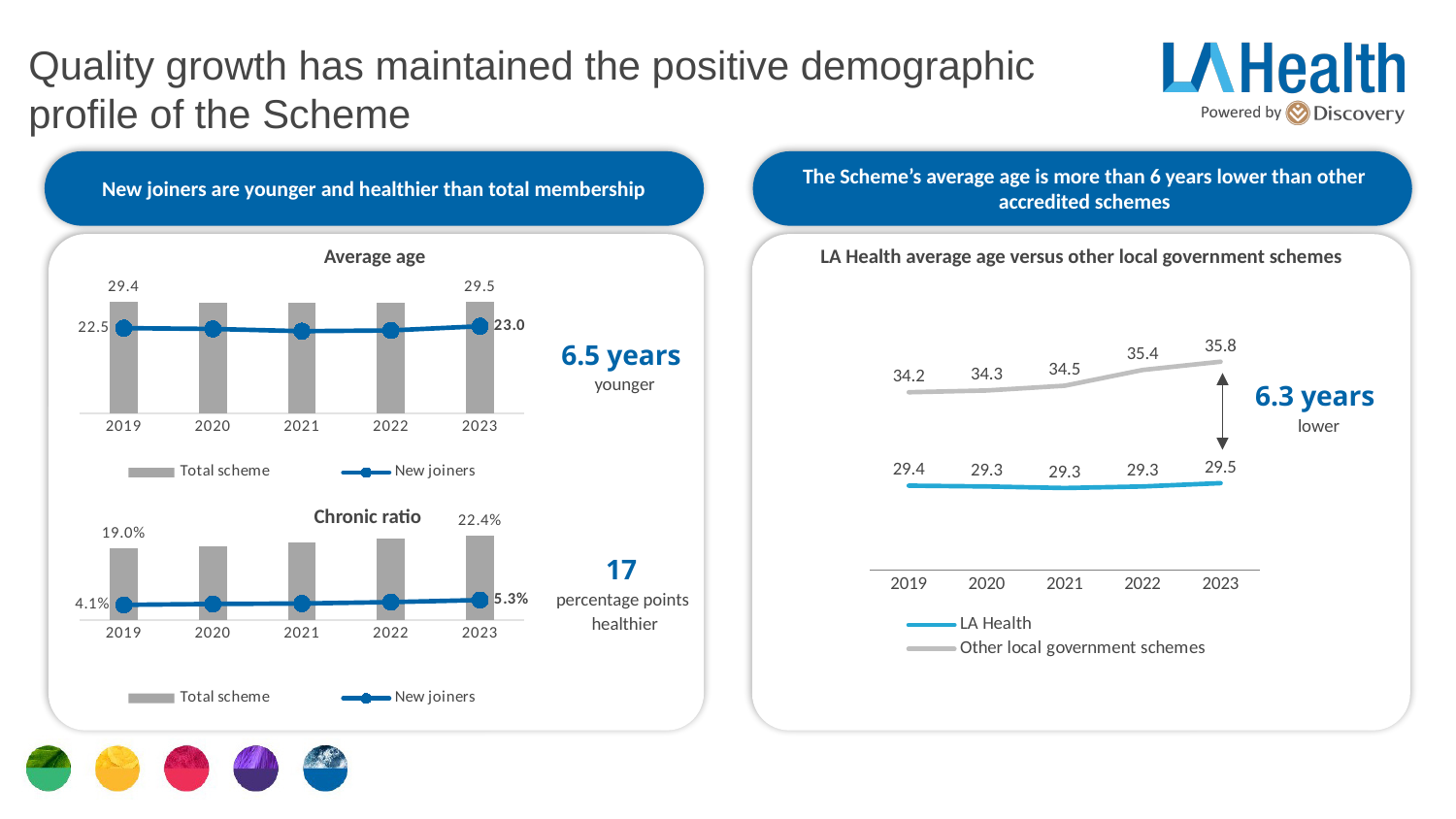
In the chart titled 'LA Health average age versus other local government schemes', what is the difference between Other local government schemes and LA Health in 2023? 6.3 In the chart titled 'LA Health average age versus other local government schemes', how many series does the legend list? 2 In the 'Chronic ratio' chart, how many years are shown on the x axis? 5 In the 'Chronic ratio' chart, which is larger in 2019: Total scheme or New joiners? Total scheme In the 'Average age' chart, what is the Total scheme value for 2019? 29.4 In the chart titled 'LA Health average age versus other local government schemes', in which year is the Other local government schemes value highest? 2023 In the chart titled 'LA Health average age versus other local government schemes', what is the LA Health value in 2021? 29.3 In the 'Chronic ratio' chart, what is the Total scheme value for 2023? 22.4% In the chart titled 'LA Health average age versus other local government schemes', what is the value for Other local government schemes in 2023? 35.8 In the chart titled 'LA Health average age versus other local government schemes', do the Other local government schemes values rise or fall from 2019 to 2023? rise In the 'Average age' chart, what is the difference between Total scheme and New joiners in 2023? 6.5 In the 'Average age' chart, what is the New joiners value for 2023? 23.0